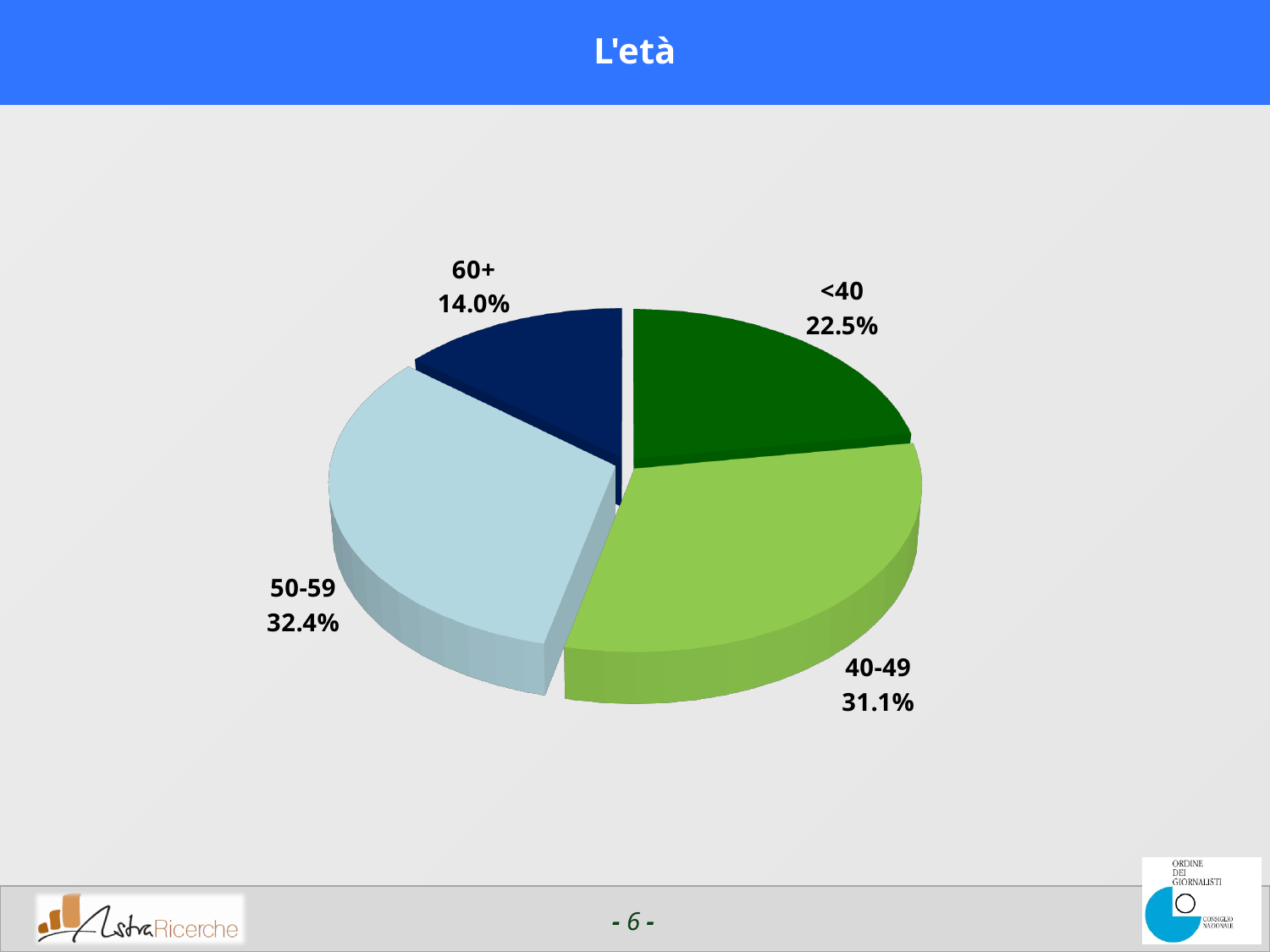
How many age groups are shown in the pie chart? 4 What is the difference in percentage points between the 40-49 and <40 shares? 8.6 What share of the pie does the 50-59 age group have? 32.4% What share of the pie does the <40 age group have? 22.5% What share of the pie does the 40-49 age group have? 31.1% Which age group has the largest share of the pie? 50-59 Which age group has the smallest share of the pie? 60+ What share of the pie does the 60+ age group have? 14.0% What is the title of the slide? L'età Which is larger, the share for <40 or the share for 60+? <40 What is the difference in percentage points between the 50-59 and 60+ shares? 18.4 What kind of chart is shown on the slide? Pie chart